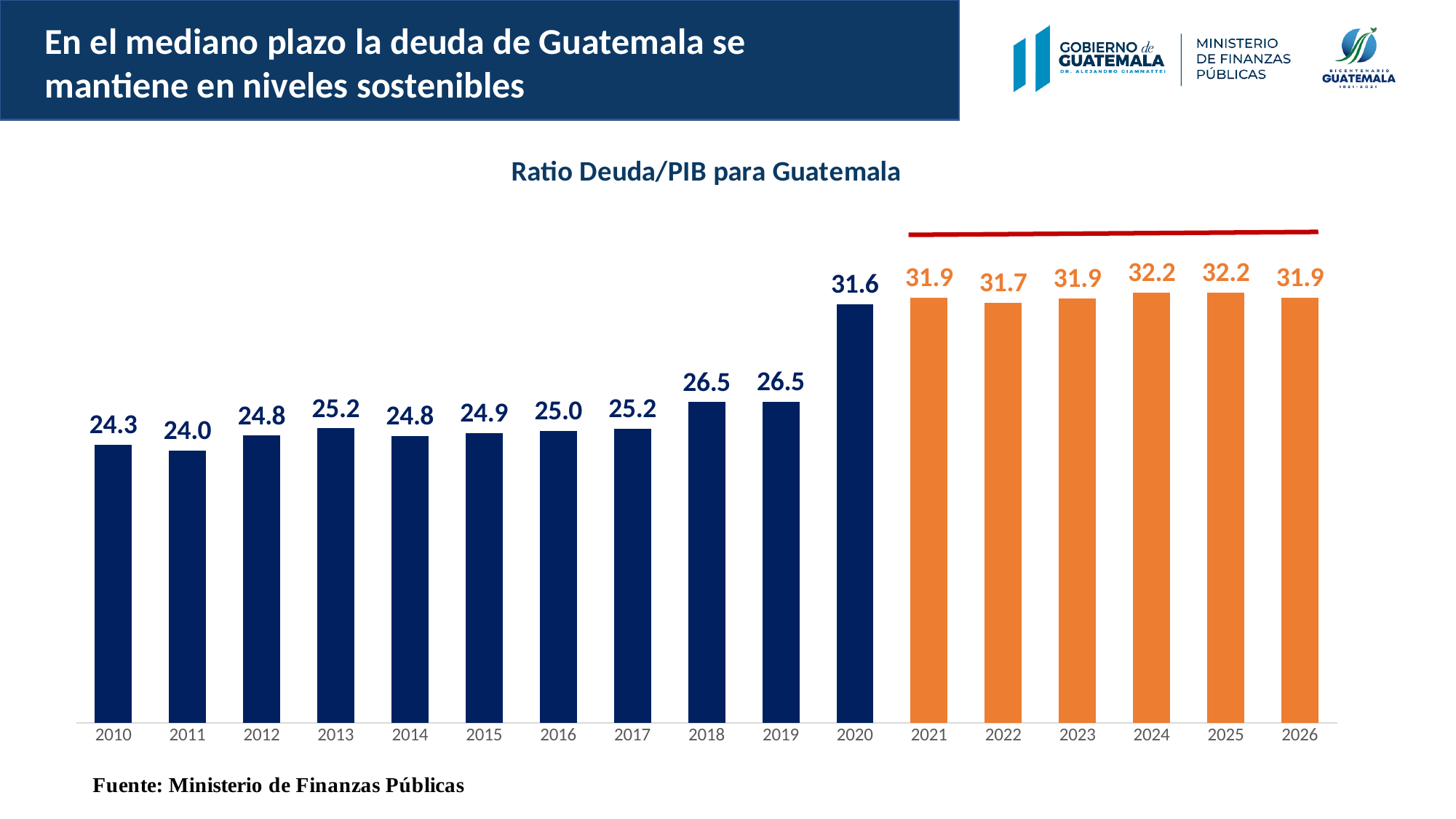
What colour are the bars for the years 2021 to 2026? Orange What is the Ratio Deuda/PIB value for 2020? 31.6 Which is larger, the Ratio Deuda/PIB value for 2018 or for 2012? 2018 What kind of chart is shown on the slide? Bar chart What is the Ratio Deuda/PIB value for 2022? 31.7 What is the title of the chart? Ratio Deuda/PIB para Guatemala What is the difference between the Ratio Deuda/PIB values for 2024 and 2010? 7.9 What is the difference between the Ratio Deuda/PIB values for 2020 and 2019? 5.1 How many years are shown on the x axis of the chart? 17 What is the highest Ratio Deuda/PIB value shown on the chart? 32.2 What is the Ratio Deuda/PIB value for 2013? 25.2 Which year has the lowest Ratio Deuda/PIB value? 2011